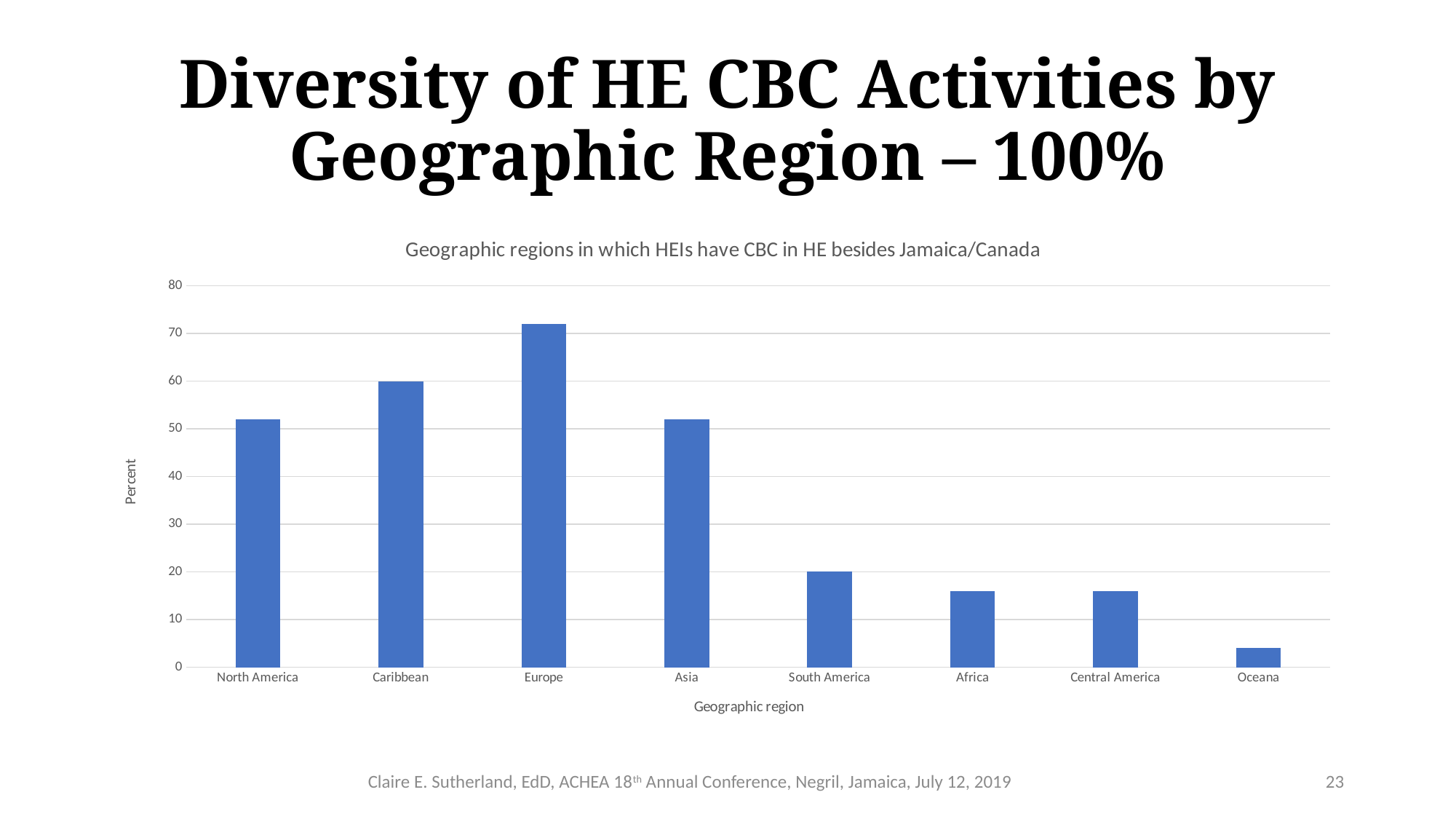
What is the difference between the percentages for the Caribbean and South America? 40 Which has a higher percentage, Europe or the Caribbean? Europe Is the value for Oceana greater or less than 10? less What is the percentage for the Caribbean? 60 What is the label of the vertical axis of the chart? Percent Is the value for Europe greater or less than 70? greater What type of chart is shown on the slide? Bar chart Which geographic region has the lowest percentage in the chart? Oceana How many geographic regions are shown on the x axis of the chart? 8 What is the percentage for South America? 20 Is the value for North America greater or less than 50? greater Which geographic region has the highest percentage in the chart? Europe